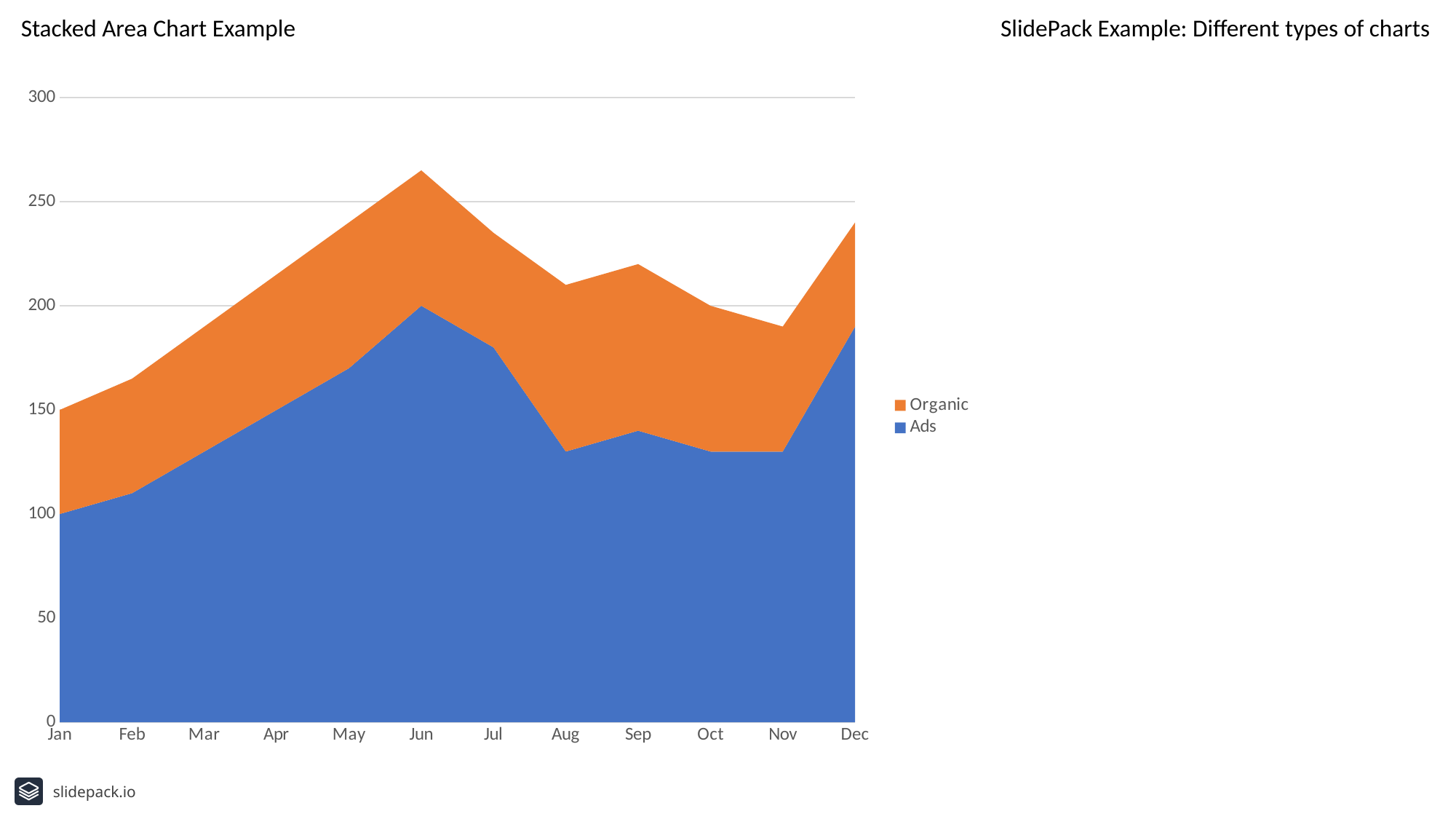
Does the Ads series rise or fall from Jan to Jun? rise Is the combined total of Ads and Organic in Jun greater or less than 250? greater In which month is the Ads series at its lowest value? Jan In which month is the combined total of Ads and Organic highest? Jun Is the value for Ads in Aug greater or less than 150? less Is the value for Ads in Dec greater or less than 150? greater How many months are shown on the x axis? 12 What kind of chart is shown on the slide? stacked area chart What is the title of the chart? Stacked Area Chart Example Which series is shown in orange? Organic In which month does the Ads series reach its highest value? Jun How many series does the legend list? 2